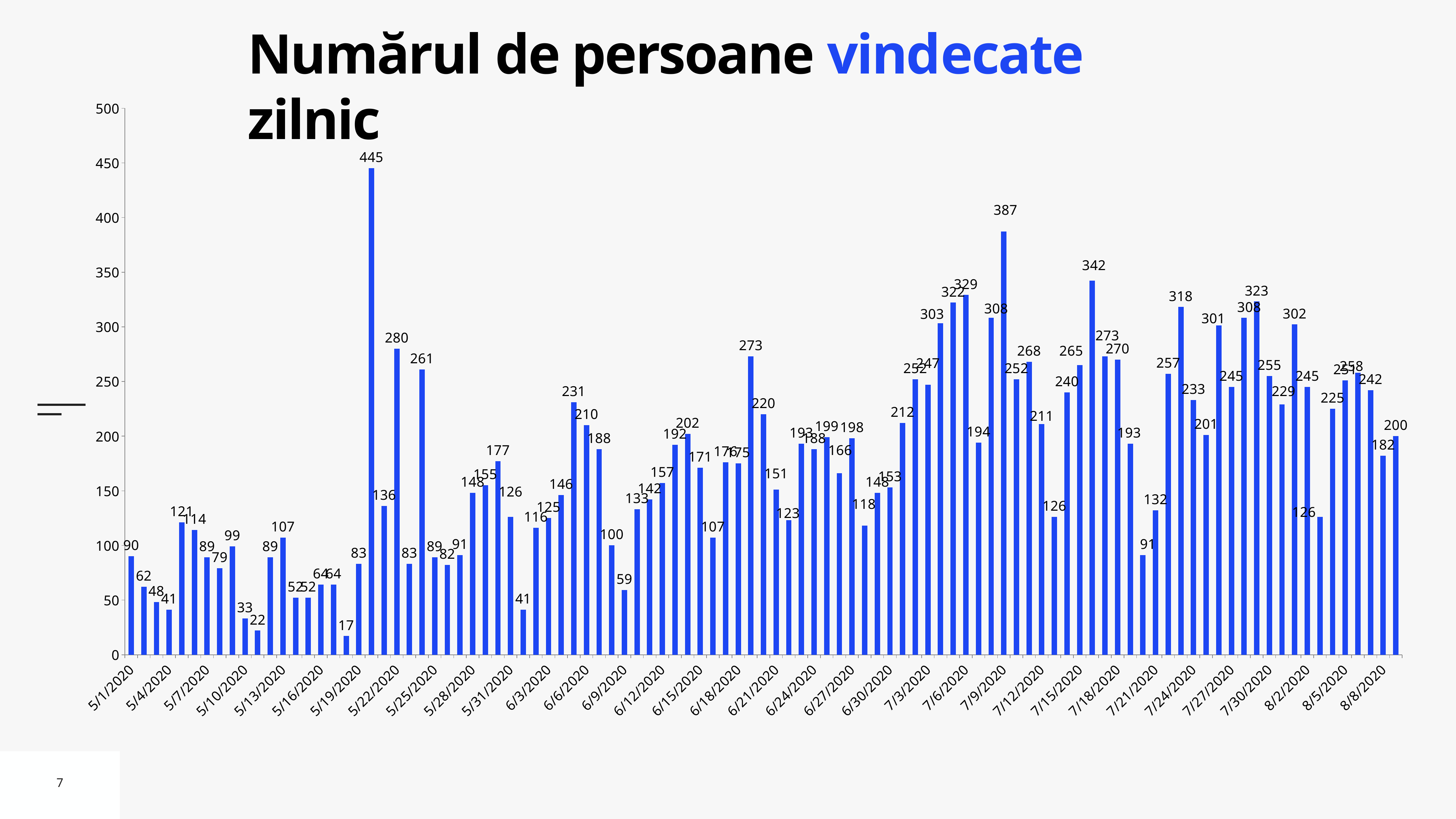
What is the highest daily value shown on the chart? 445 Is the value for 8/8/2020 greater or less than 150? greater Overall, do the daily values tend to rise or fall from May to August? Rise What is the lowest daily value shown on the chart? 17 What is the title of the chart? Numărul de persoane vindecate zilnic What is the value for 5/1/2020, the first bar on the chart? 90 What is the value of the tallest bar near 7/9/2020? 387 Is the value for 5/1/2020 greater or less than 100? less What is the difference between the highest bar (445) and the second-highest bar (387)? 58 What kind of chart is shown on the slide? Bar chart Which is larger, the value for 5/22/2020 (280) or the value for 5/25/2020 (89)? 5/22/2020